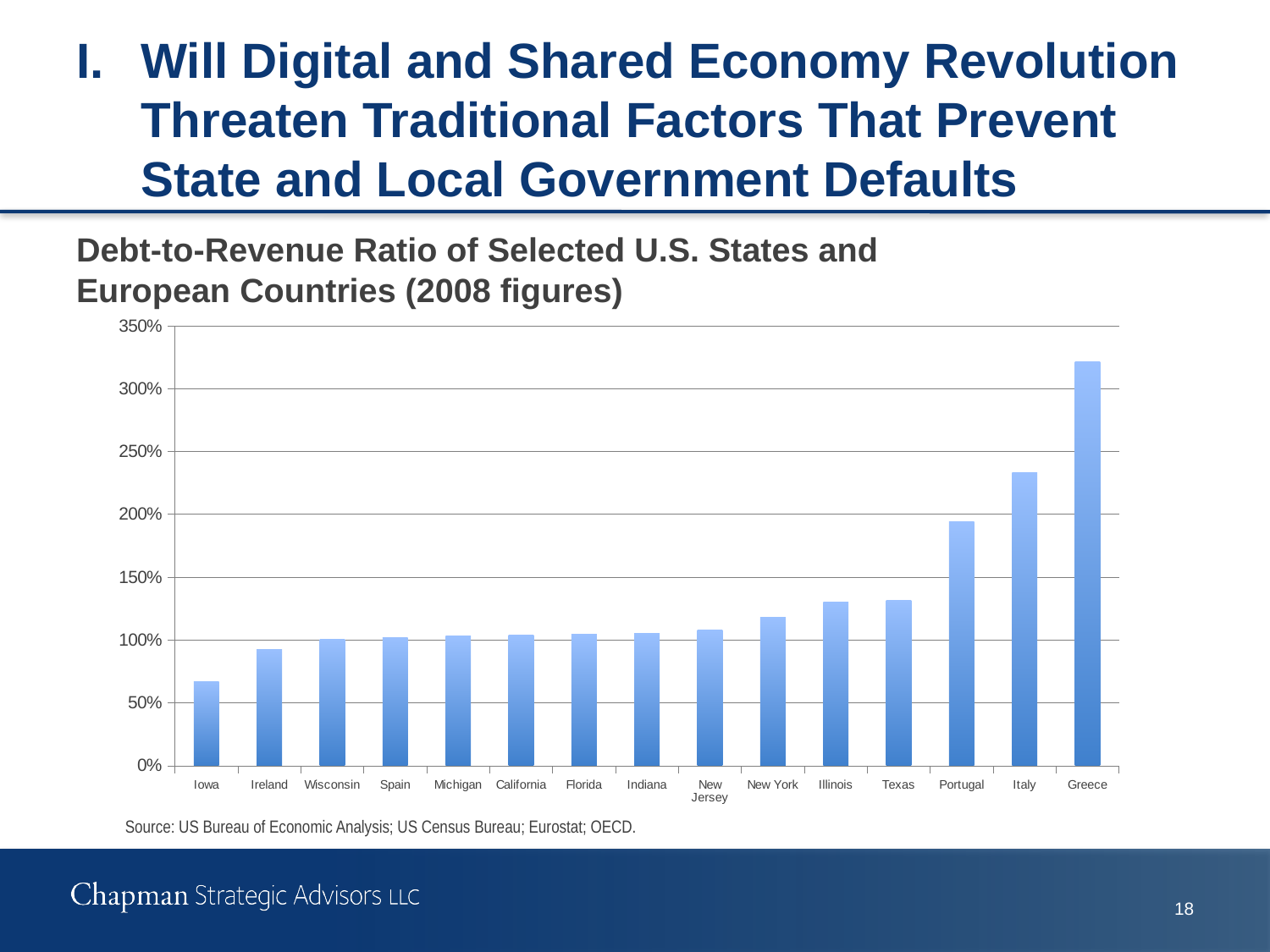
How many states and countries are shown on the x axis of the chart? 15 Is the value for Portugal greater or less than 200%? less Do the values generally rise or fall moving from left to right along the x axis? Rise Is the value for Greece greater or less than 300%? greater Is the value for Italy greater or less than 200%? greater Which state or country has the lowest debt-to-revenue ratio in the chart? Iowa What is the title of the chart? Debt-to-Revenue Ratio of Selected U.S. States and European Countries (2008 figures) Which state or country has the highest debt-to-revenue ratio in the chart? Greece What kind of chart is shown on the slide? Bar chart Which has a higher debt-to-revenue ratio, Portugal or New York? Portugal